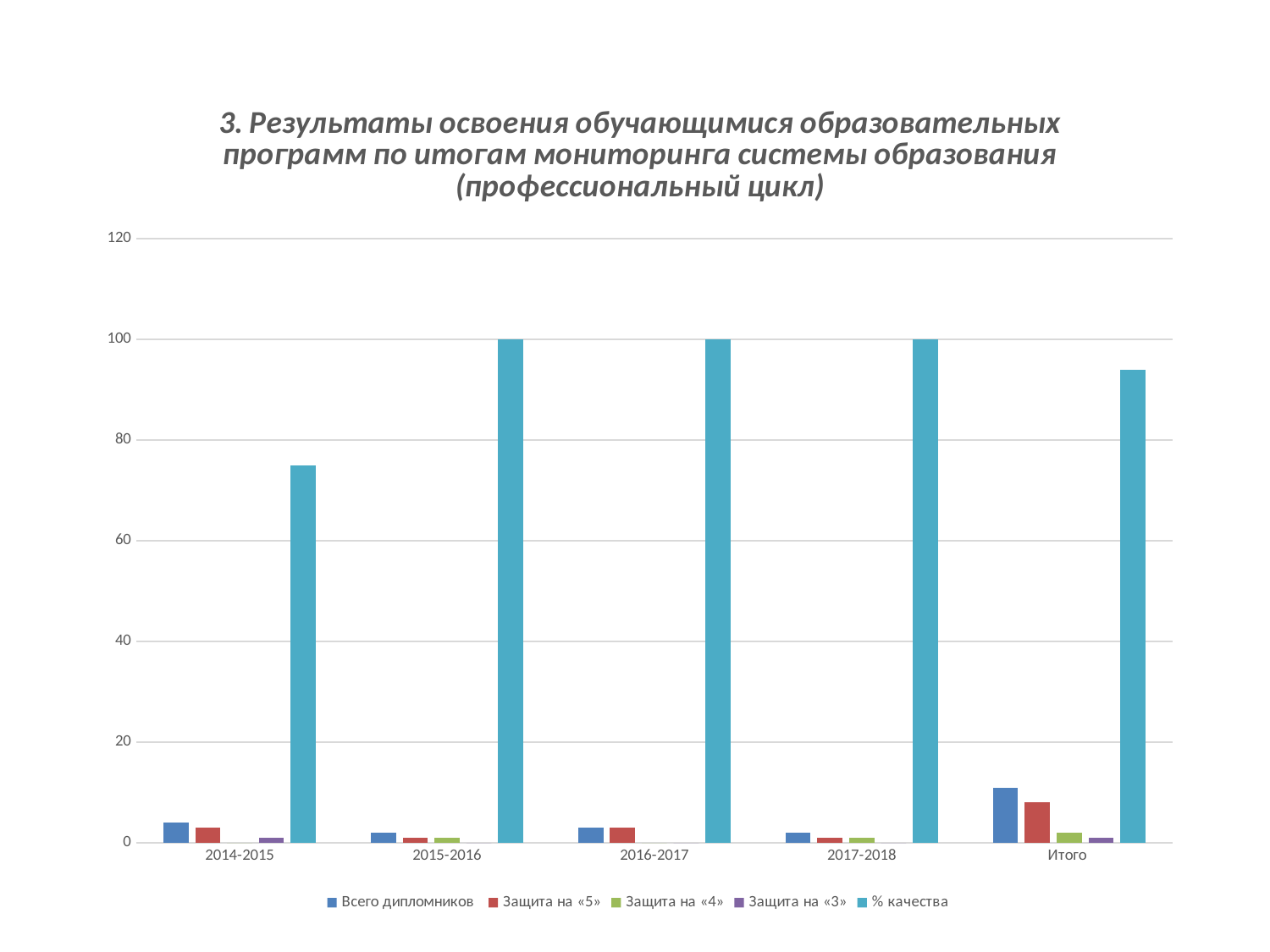
What kind of chart is shown on the slide? bar chart Is the value of "% качества" for Итого greater or less than 80? greater Which category has the lowest value of "% качества"? 2014-2015 Which category has the highest value of "Всего дипломников"? Итого Is the value of "Всего дипломников" for Итого greater or less than 20? less What is the value of "% качества" for 2017-2018? 100 What is the value of "% качества" for 2015-2016? 100 What is the last entry in the legend? % качества Is the value of "% качества" for 2014-2015 greater or less than 80? less How many series does the legend list? 5 How many categories are shown on the x axis? 5 Does the value of "% качества" rise or fall from 2014-2015 to 2015-2016? rise